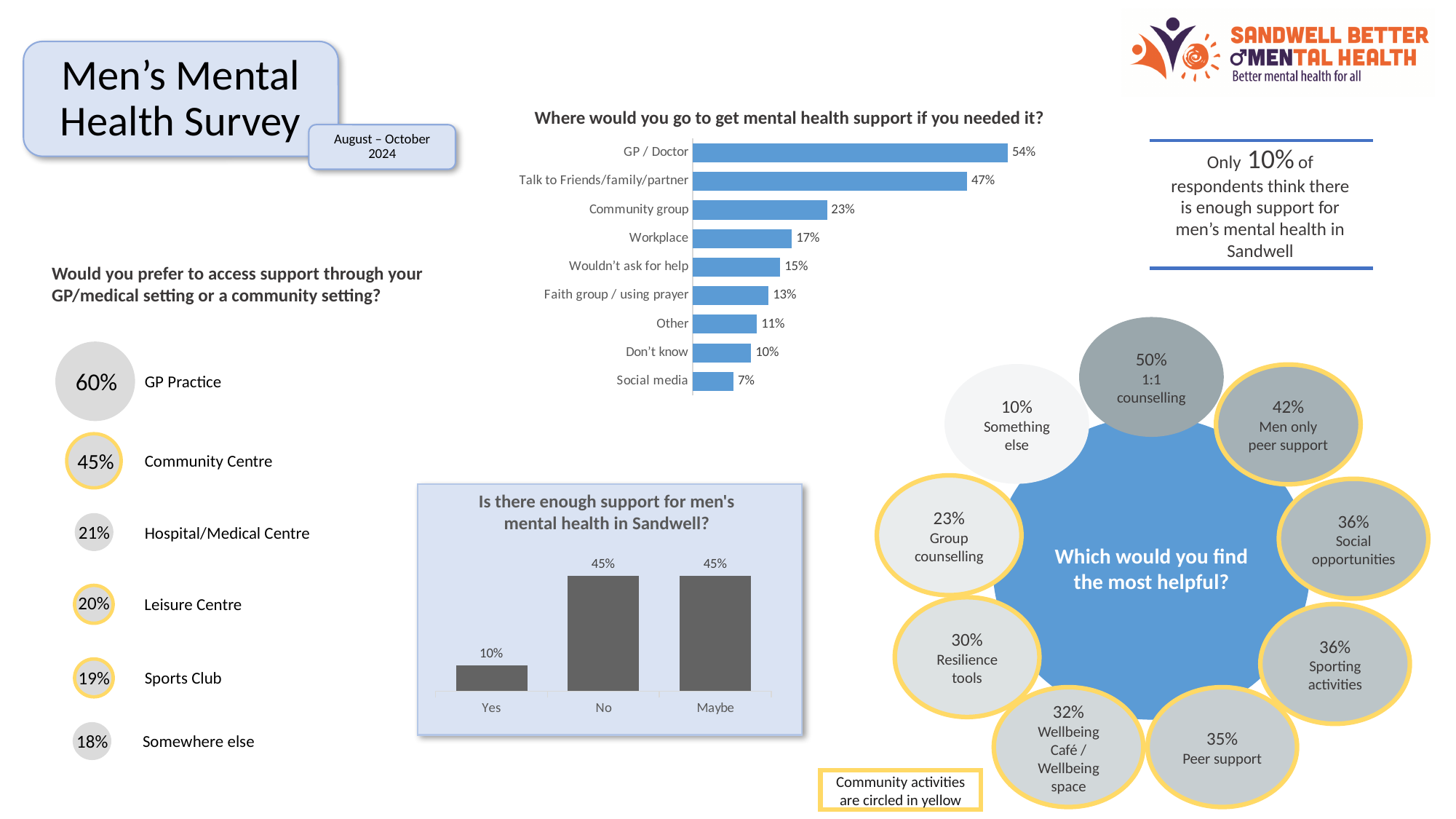
In the chart 'Where would you go to get mental health support if you needed it?', which is larger: Community group or Faith group / using prayer? Community group In the chart 'Is there enough support for men's mental health in Sandwell?', what is the value for Yes? 10% In the chart 'Is there enough support for men's mental health in Sandwell?', what is the value for No? 45% How many categories are shown in the chart 'Where would you go to get mental health support if you needed it?' 9 In the chart 'Where would you go to get mental health support if you needed it?', which category has the lowest value? Social media In the chart 'Where would you go to get mental health support if you needed it?', what is the difference between GP / Doctor and Talk to Friends/family/partner? 7% What kind of chart is 'Where would you go to get mental health support if you needed it?' Bar chart In the chart 'Is there enough support for men's mental health in Sandwell?', what is the difference between No and Yes? 35% In the chart 'Where would you go to get mental health support if you needed it?', what is the value for Workplace? 17% In the chart 'Where would you go to get mental health support if you needed it?', what is the value for GP / Doctor? 54% In the chart 'Where would you go to get mental health support if you needed it?', which category has the highest value? GP / Doctor How many categories are shown in the chart 'Is there enough support for men's mental health in Sandwell?' 3